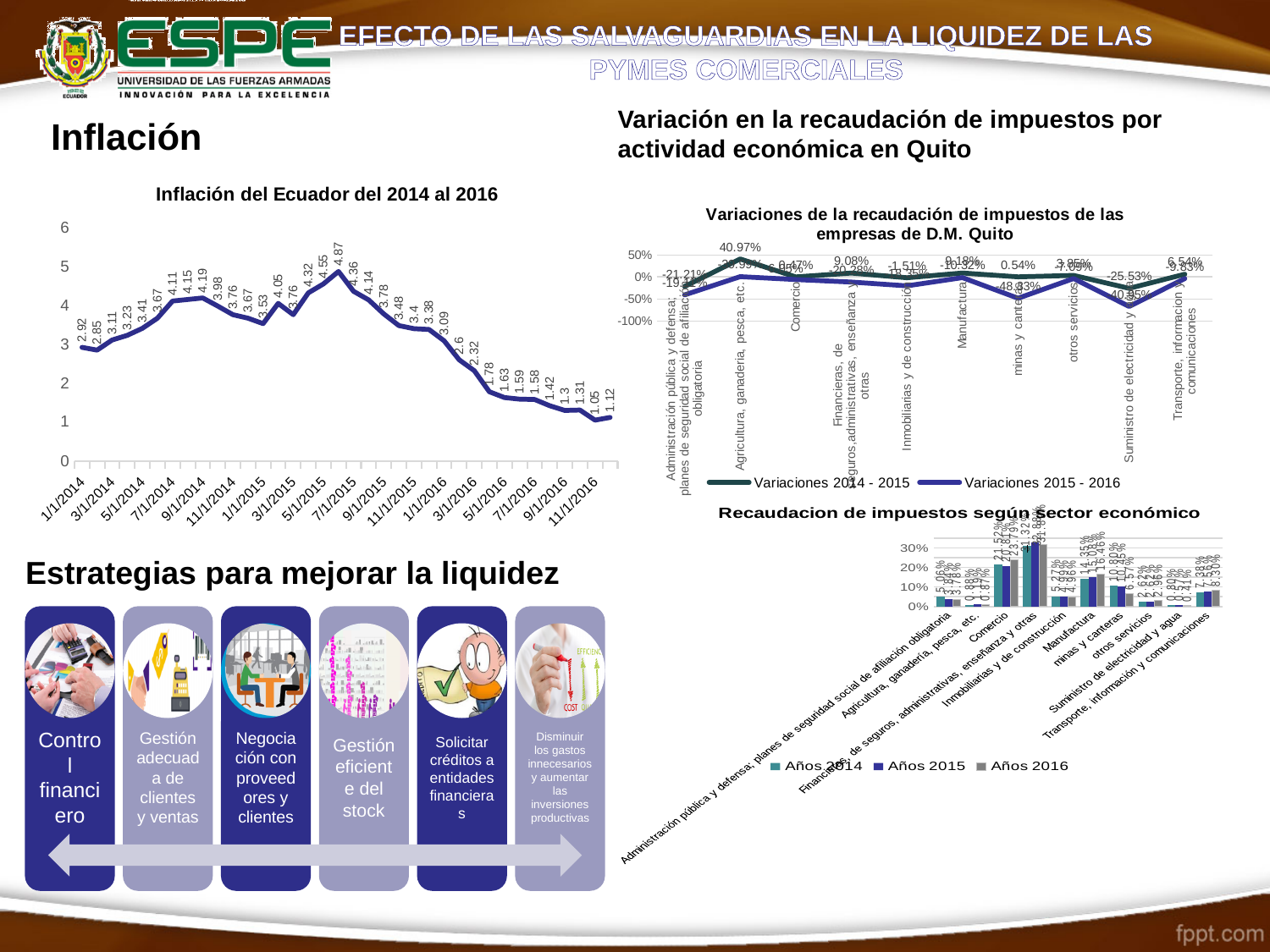
What kind of chart is 'Inflación del Ecuador del 2014 al 2016'? line chart In the chart 'Inflación del Ecuador del 2014 al 2016', what is the highest inflation value shown? 4.87 In the chart 'Inflación del Ecuador del 2014 al 2016', do the values overall rise or fall from the start of 2014 to the end of 2016? fall In the chart 'Variaciones de la recaudación de impuestos de las empresas de D.M. Quito', what is the highest value labelled on the chart? 40.97% In the chart 'Variaciones de la recaudación de impuestos de las empresas de D.M. Quito', what are the two legend entries? Variaciones 2014 - 2015 and Variaciones 2015 - 2016 In the chart 'Recaudacion de impuestos según sector económico', how many series does the legend list? 3 In the chart 'Inflación del Ecuador del 2014 al 2016', what is the inflation value for 1/1/2014? 2.92 What kind of chart is 'Recaudacion de impuestos según sector económico'? bar chart In the chart 'Inflación del Ecuador del 2014 al 2016', what is the last value plotted at the end of 2016? 1.12 In the chart 'Inflación del Ecuador del 2014 al 2016', what is the difference between the highest value (4.87) and the lowest value (1.05)? 3.82 In the chart 'Inflación del Ecuador del 2014 al 2016', what is the lowest inflation value shown? 1.05 In the chart 'Variaciones de la recaudación de impuestos de las empresas de D.M. Quito', how many series does the legend list? 2